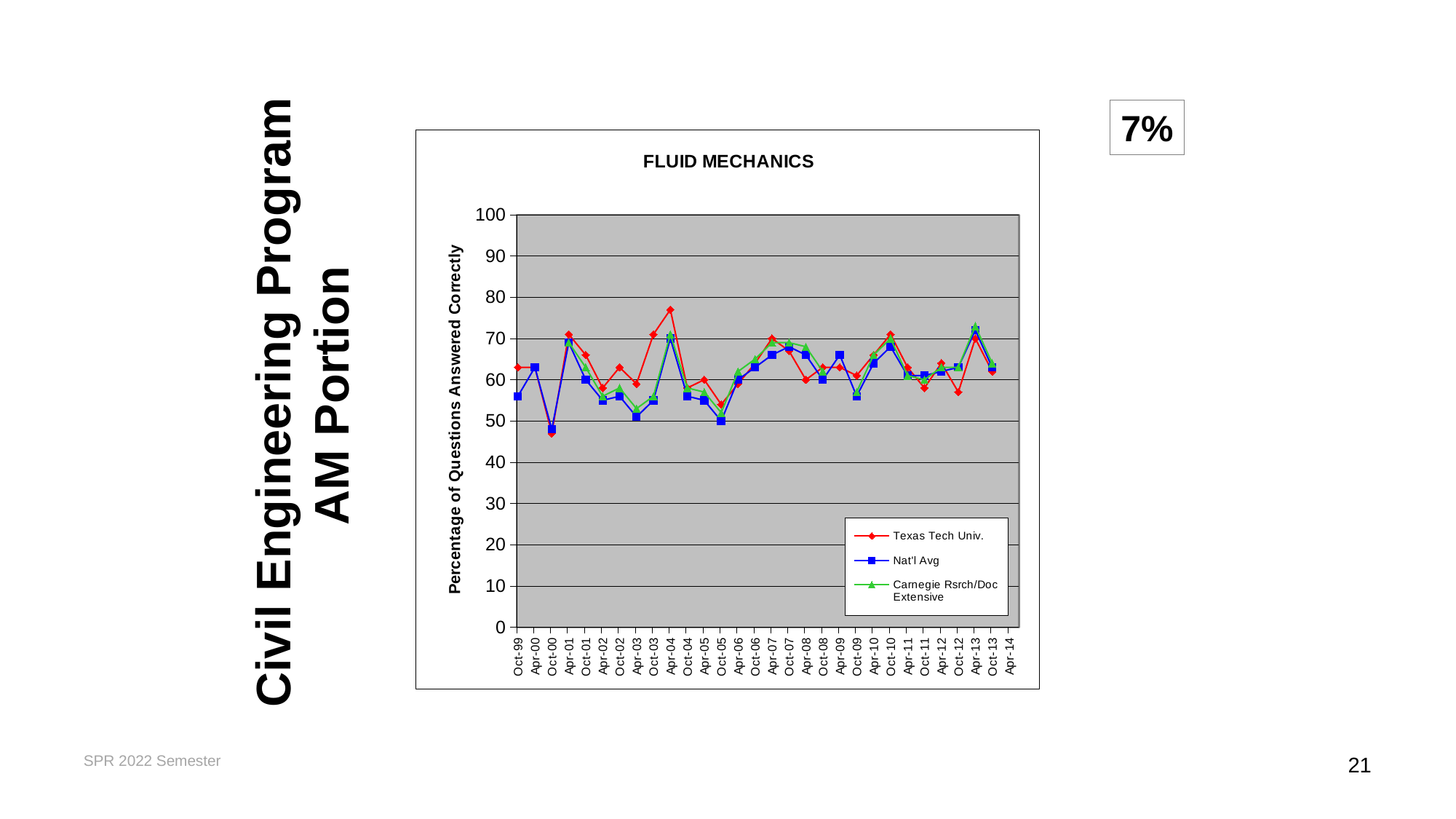
How many series does the legend of the FLUID MECHANICS chart list? 3 At Oct-03, which is larger: the Texas Tech Univ. value or the Nat'l Avg value? Texas Tech Univ. What is the title of the chart? FLUID MECHANICS At which date does the Texas Tech Univ. series reach its lowest value? Oct-00 At which date does the Texas Tech Univ. series reach its highest value? Apr-04 Is the Nat'l Avg value for Apr-00 greater or less than 60? greater What is the label of the vertical axis of the chart? Percentage of Questions Answered Correctly Is the Nat'l Avg value for Oct-00 greater or less than 50? less Is the Texas Tech Univ. value for Oct-12 greater or less than 60? less What kind of chart is shown on the slide? line chart